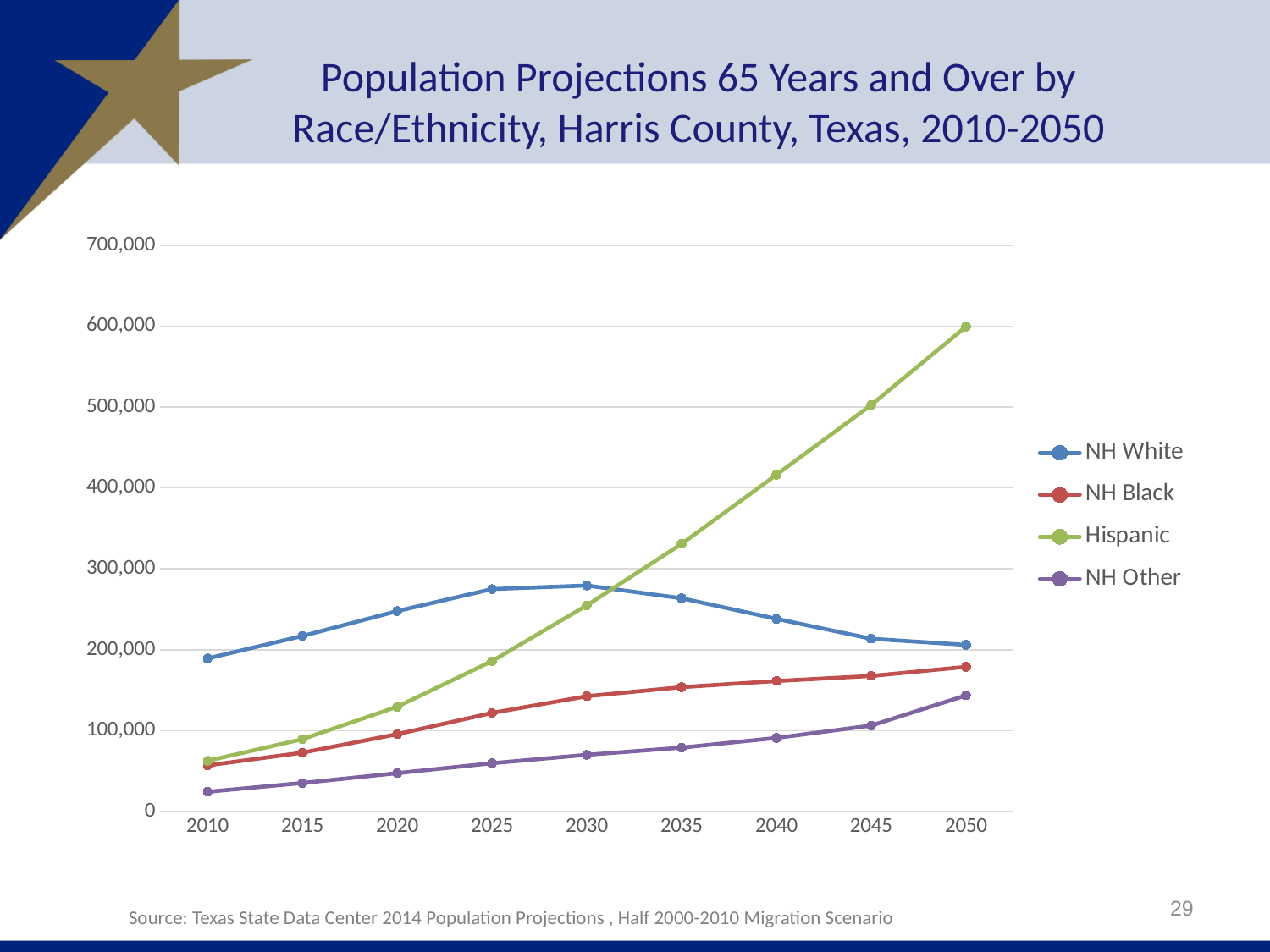
How many years are plotted along the x axis? 9 Is the value for NH Other in 2050 greater or less than 100,000? greater Which series has the lowest value in 2010? NH Other Is the value for Hispanic in 2040 greater or less than 400,000? greater In 2035, which is larger: the value for Hispanic or the value for NH White? Hispanic Which series has the highest value in 2050? Hispanic Does the Hispanic series rise or fall from 2010 to 2050? Rise Is the value for NH Black in 2050 greater or less than 200,000? less What is the title of the chart? Population Projections 65 Years and Over by Race/Ethnicity, Harris County, Texas, 2010-2050 How many series does the legend list? 4 What kind of chart is shown on the slide? Line chart